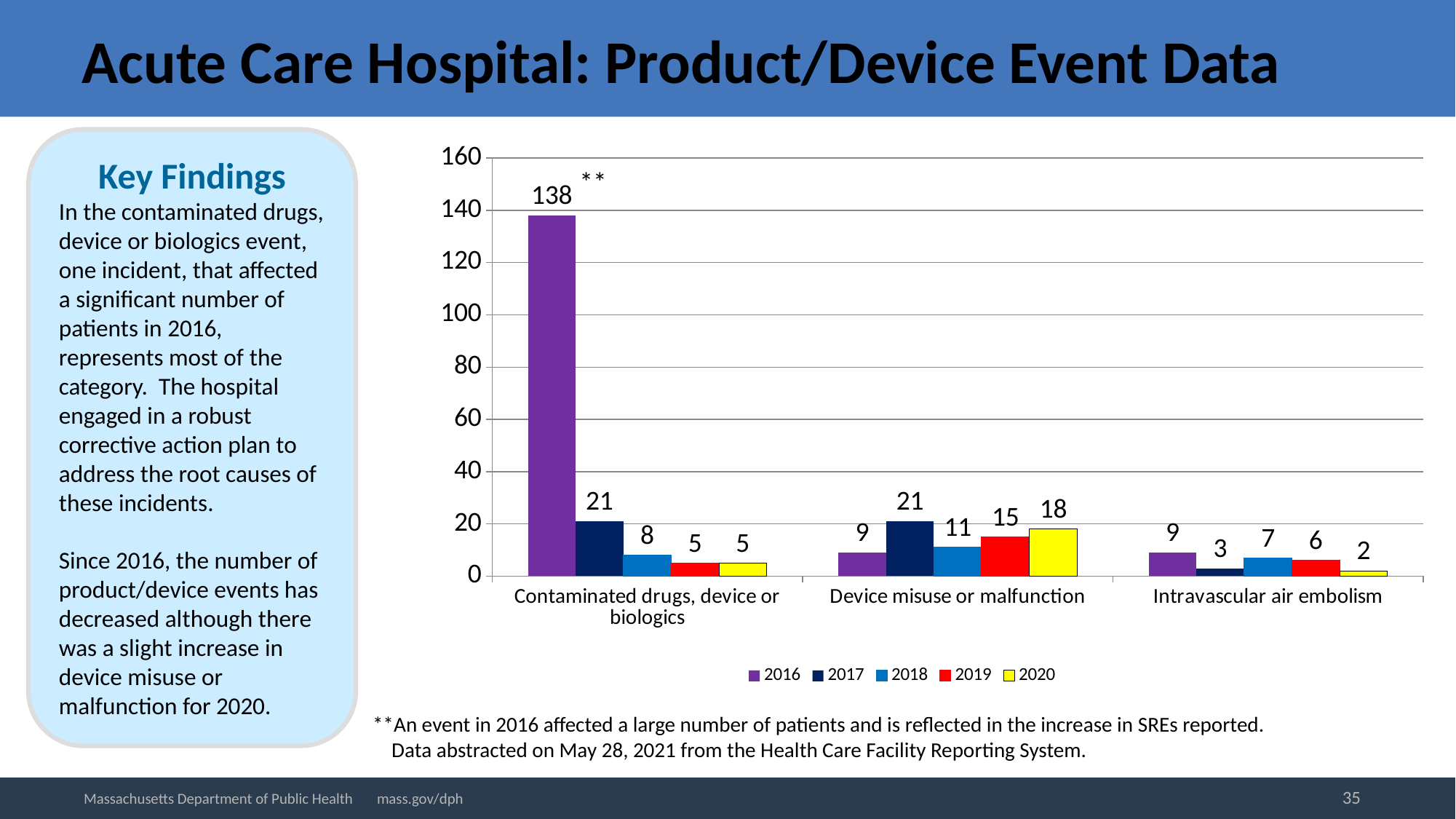
Is the 2016 value for Contaminated drugs, device or biologics greater or less than 120? greater How many categories are shown on the x axis? 3 What is the value for 2016 in the Contaminated drugs, device or biologics category? 138 Which is larger: the 2019 value for Device misuse or malfunction or the 2019 value for Intravascular air embolism? Device misuse or malfunction What is the value for 2020 in the Device misuse or malfunction category? 18 Which year has the lowest value in the Intravascular air embolism category? 2020 How many series does the legend list? 5 What kind of chart is shown on the slide? bar chart Which year has the highest value in the Device misuse or malfunction category? 2017 What is the value for 2017 in the Intravascular air embolism category? 3 What is the difference between the 2016 and 2017 values in the Contaminated drugs, device or biologics category? 117 Which colour represents 2020 in the legend? yellow